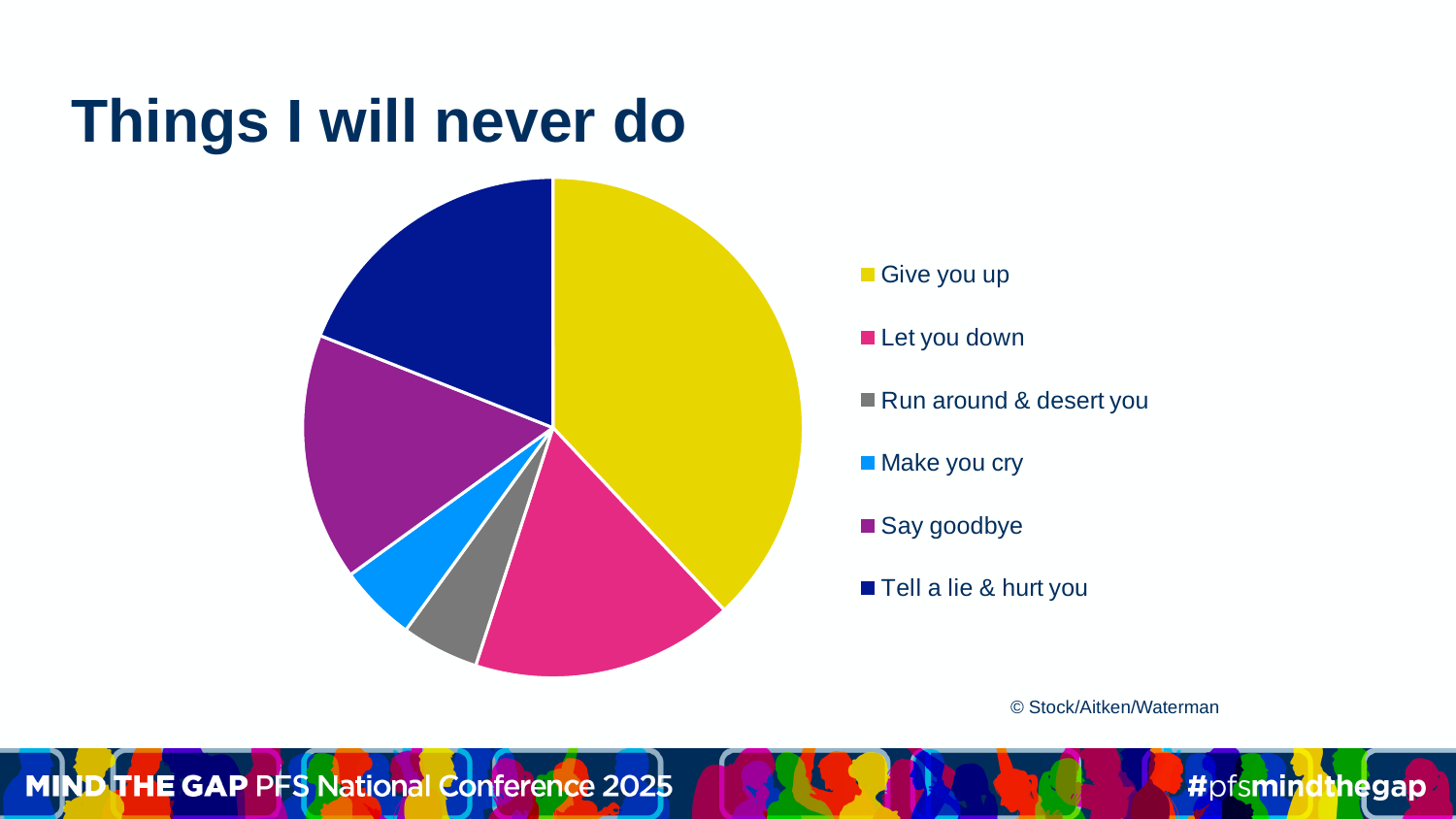
What is the title of the chart on the slide? Things I will never do Which slice is larger, Let you down or Make you cry? Let you down Which slice is larger, Tell a lie & hurt you or Run around & desert you? Tell a lie & hurt you How many categories does the pie chart have? 6 What kind of chart is shown on the slide? Pie chart Which category has the largest slice of the pie? Give you up Which slice is larger, Say goodbye or Make you cry? Say goodbye How many entries does the legend list? 6 Which colour represents Give you up in the pie chart? Yellow